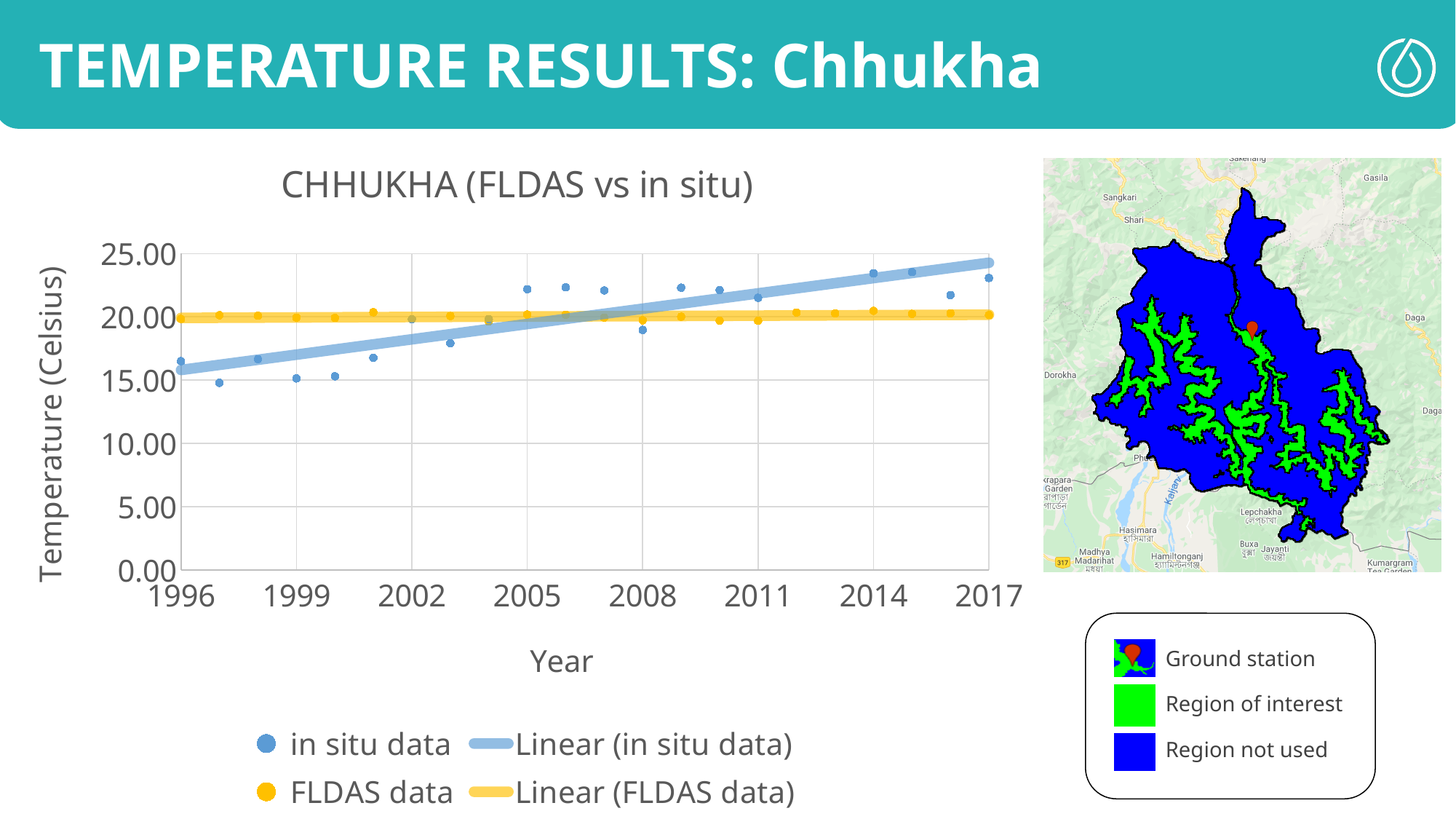
What kind of chart is shown on the slide? scatter chart How many entries does the chart legend list? 4 In 2017, which is larger: the in situ data value or the FLDAS data value? in situ data Is the in situ data value for 2008 greater or less than 20.00? less Is the in situ data value for 2005 greater or less than 20.00? greater Is the in situ data value for 1996 greater or less than 15.00? greater What is the label of the vertical axis? Temperature (Celsius) What is the highest value shown on the vertical axis? 25.00 Do the in situ data values generally rise or fall from 1996 to 2017? rise In 1996, which is larger: the in situ data value or the FLDAS data value? FLDAS data What is the title of the chart? CHHUKHA (FLDAS vs in situ)